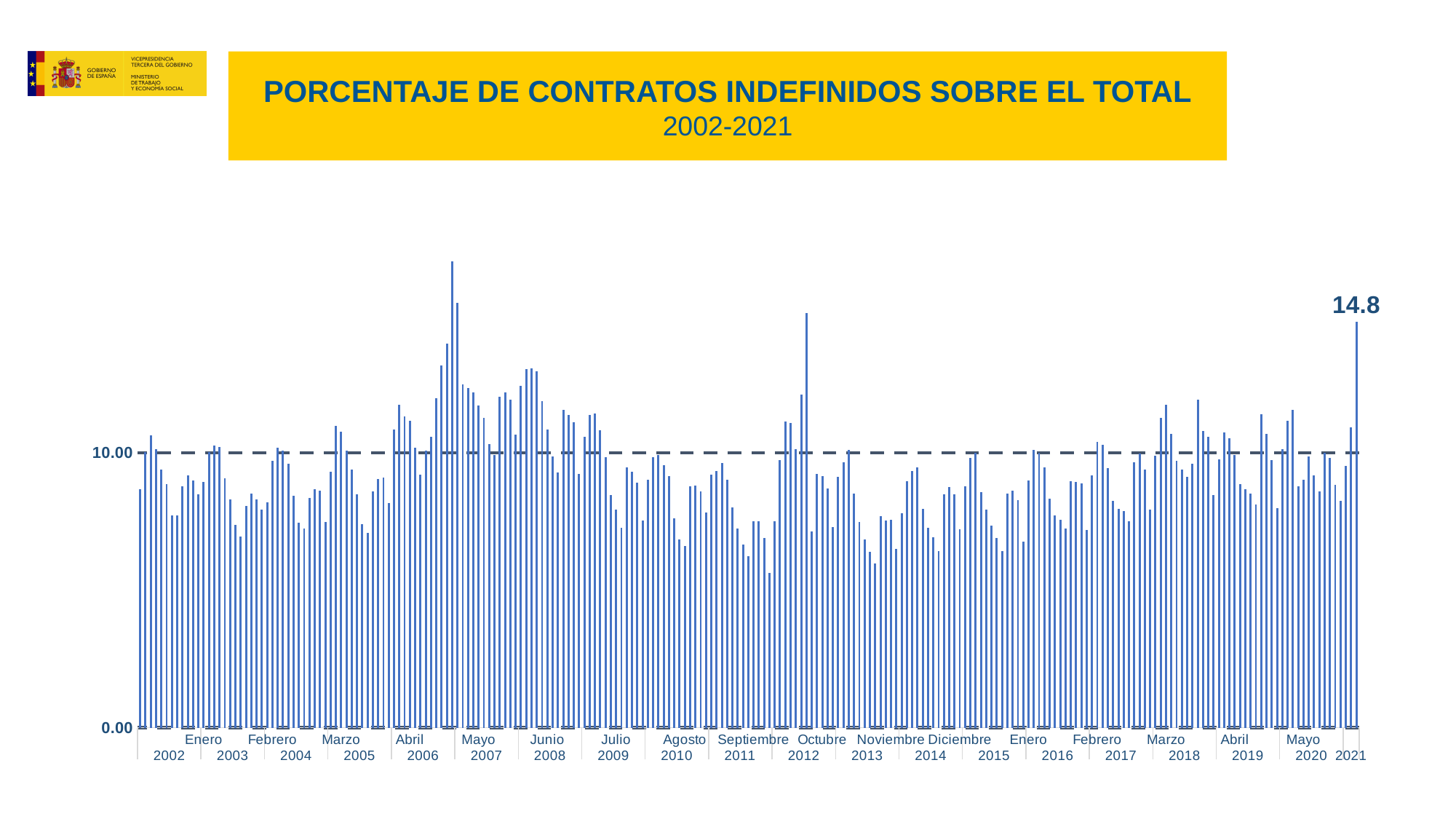
What kind of chart is shown on the slide? bar chart In which year does the tallest bar of the chart appear? 2006 What value is printed as the data label on the last bar (2021)? 14.8 What is the title of the chart on the slide? PORCENTAJE DE CONTRATOS INDEFINIDOS SOBRE EL TOTAL 2002-2021 Is the value for the last bar (2021) greater or less than 10.00? greater Which is higher: the tallest bar in 2006 or the last bar labelled 14.8 in 2021? the tallest bar in 2006 Is the tallest bar in 2006 greater or less than 10.00? greater What value does the dashed horizontal line on the chart mark? 10.00